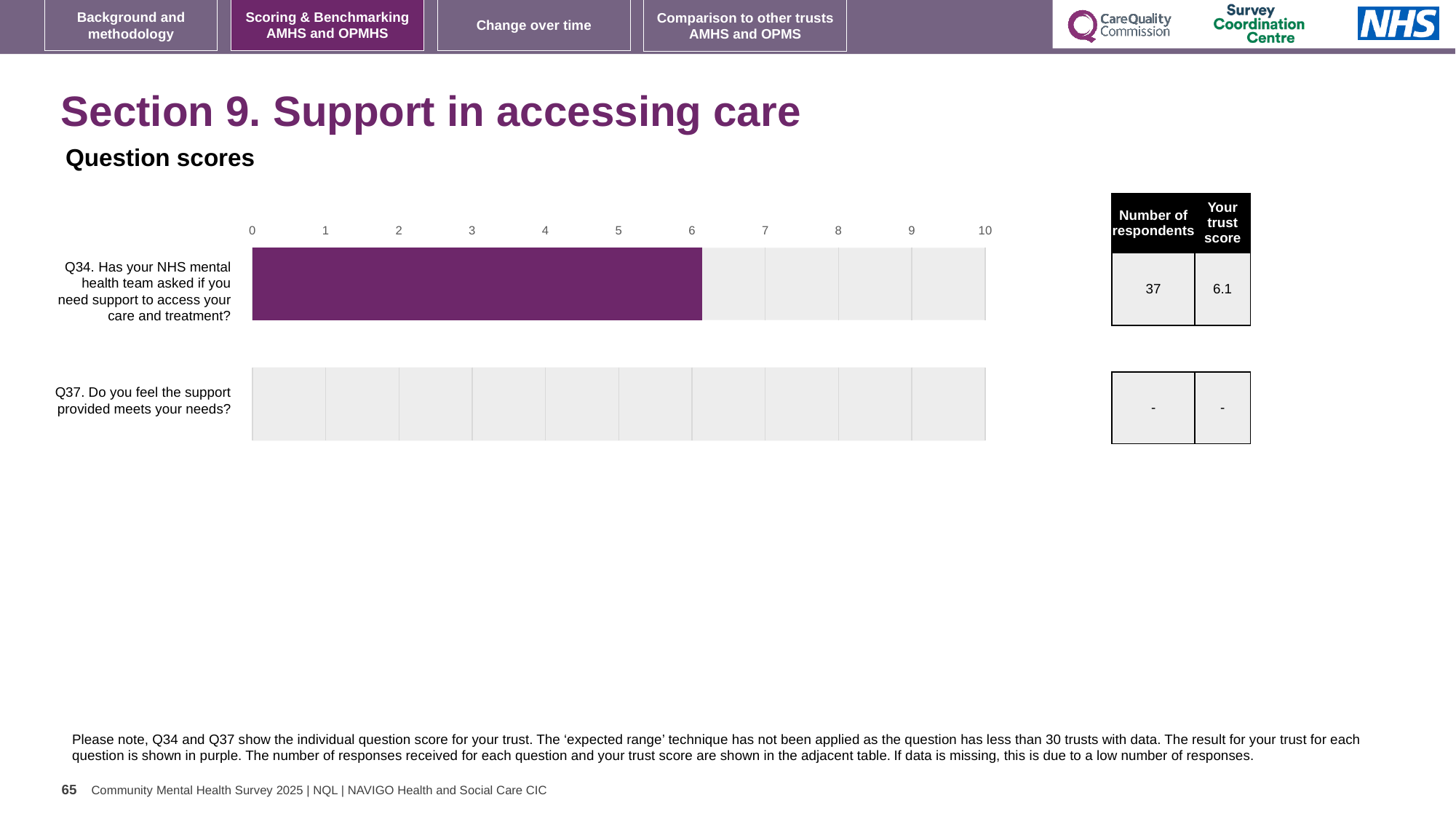
Is the bar for Q34 greater or less than 7 on the axis? less What kind of chart is shown on the slide? Bar chart What colour is the bar showing the trust's score for Q34? Purple How many respondents answered Q34? 37 How many questions are listed on the chart? 2 Is the bar for Q34 greater or less than 5 on the axis? greater What is the trust score for Q34 (Has your NHS mental health team asked if you need support to access your care and treatment?)? 6.1 What is the heading shown above the chart? Question scores What is shown as the trust score for Q37 (Do you feel the support provided meets your needs?)? -